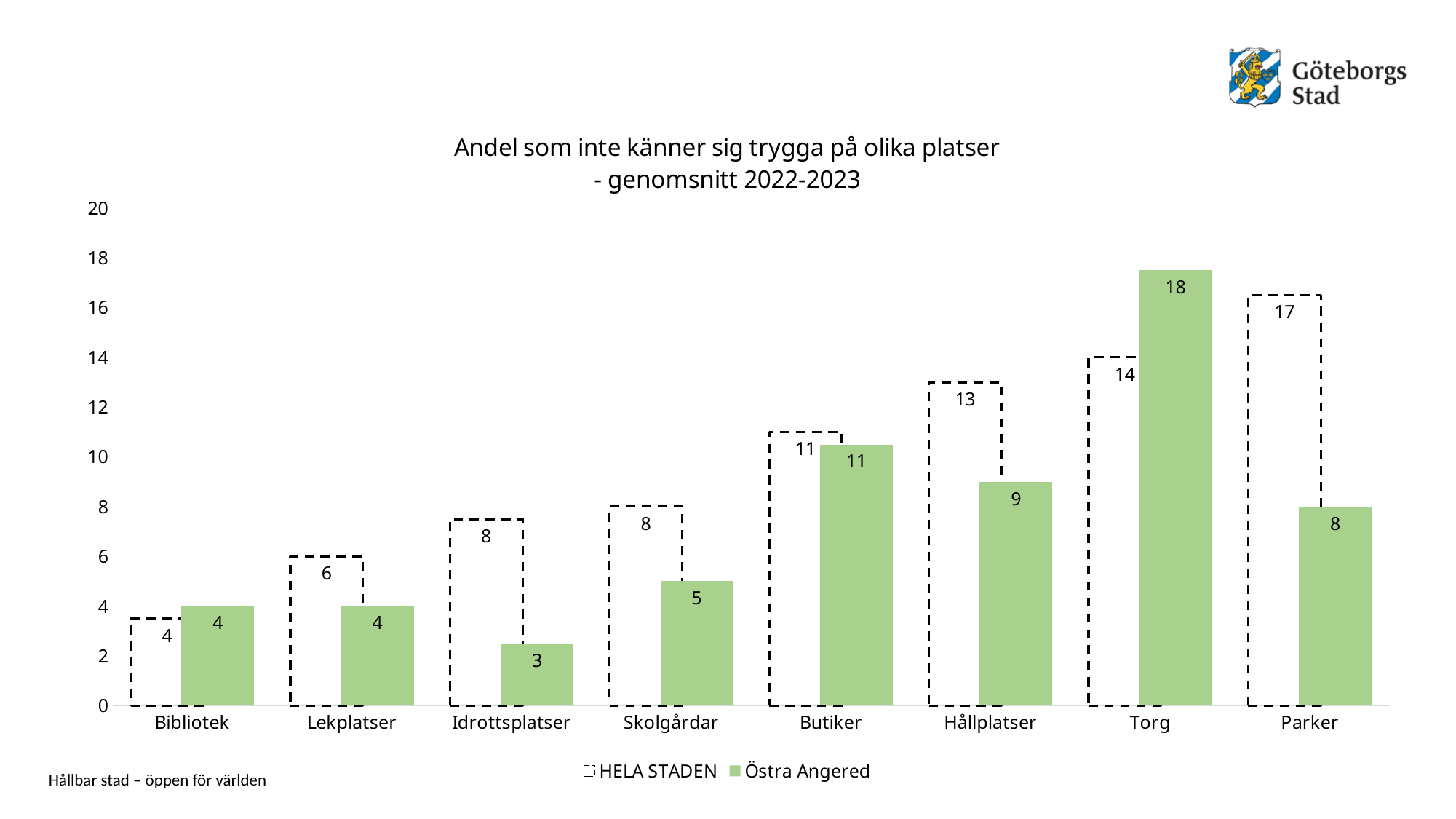
At Torg, which is larger: HELA STADEN or Östra Angered? Östra Angered What is the value for HELA STADEN at Hållplatser? 13 Which category has the highest value for Östra Angered? Torg What is the value for HELA STADEN at Parker? 17 Which category has the lowest value for Östra Angered? Idrottsplatser How many categories are shown on the x axis? 8 What is the value for Östra Angered at Torg? 18 Which category has the highest value for HELA STADEN? Parker How many series does the legend list? 2 What is the difference between HELA STADEN and Östra Angered at Parker? 9 What kind of chart is shown on the slide? Bar chart What is the value for Östra Angered at Idrottsplatser? 3